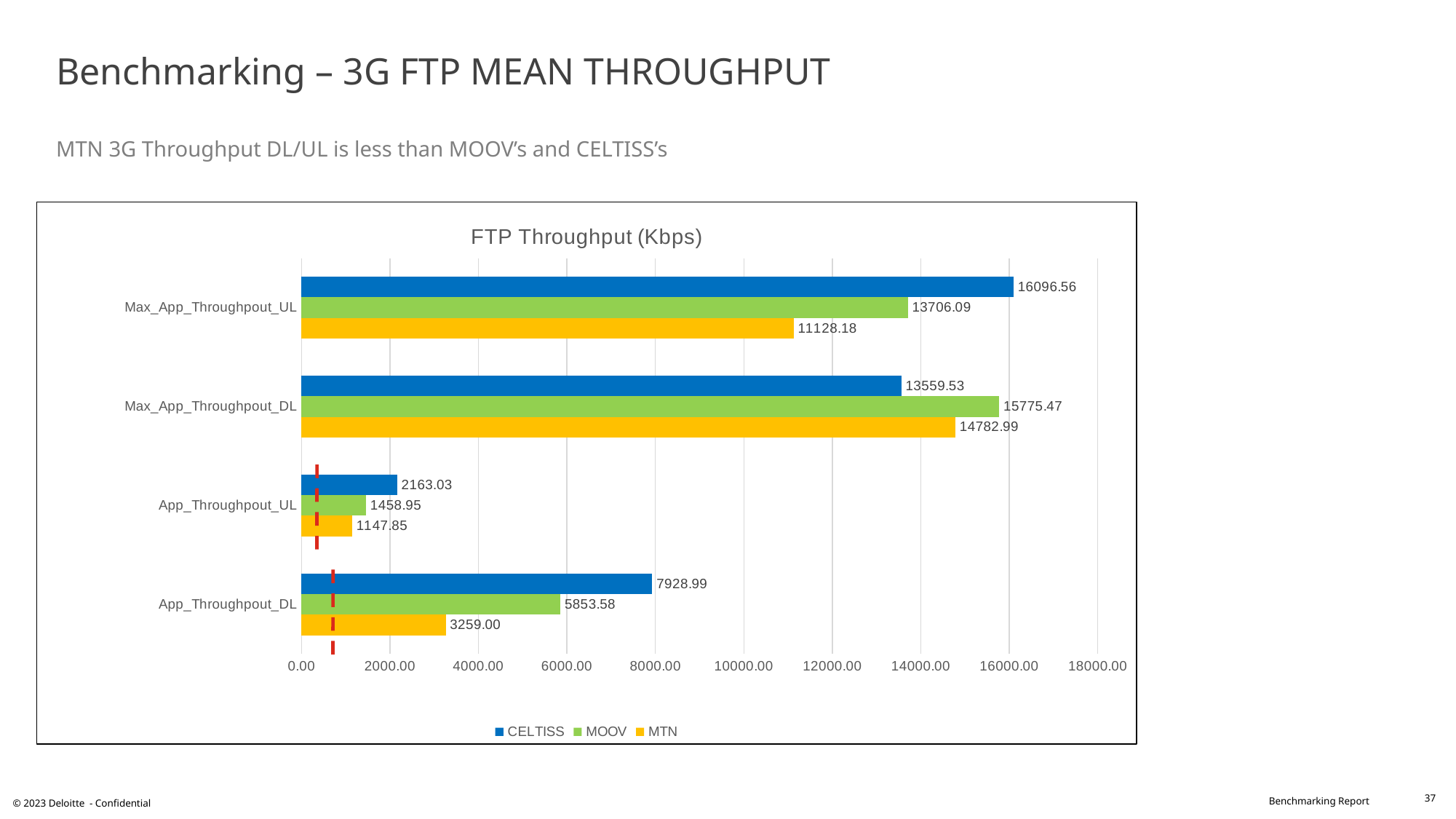
How many series does the legend list? 3 For Max_App_Throughpout_UL, which is larger: the MOOV value or the MTN value? MOOV How many categories are shown on the chart? 4 Which operator has the highest value for Max_App_Throughpout_DL? MOOV What is the difference between the CELTISS and MTN values for App_Throughpout_DL? 4669.99 What is the title of the chart? FTP Throughput (Kbps) What is the CELTISS value for Max_App_Throughpout_UL? 16096.56 What is the MOOV value for Max_App_Throughpout_DL? 15775.47 Which operator has the lowest value for App_Throughpout_UL? MTN Is the MTN value for Max_App_Throughpout_UL greater or less than 10000.00? greater What is the MTN value for App_Throughpout_DL? 3259.00 What type of chart is shown on the slide? Bar chart